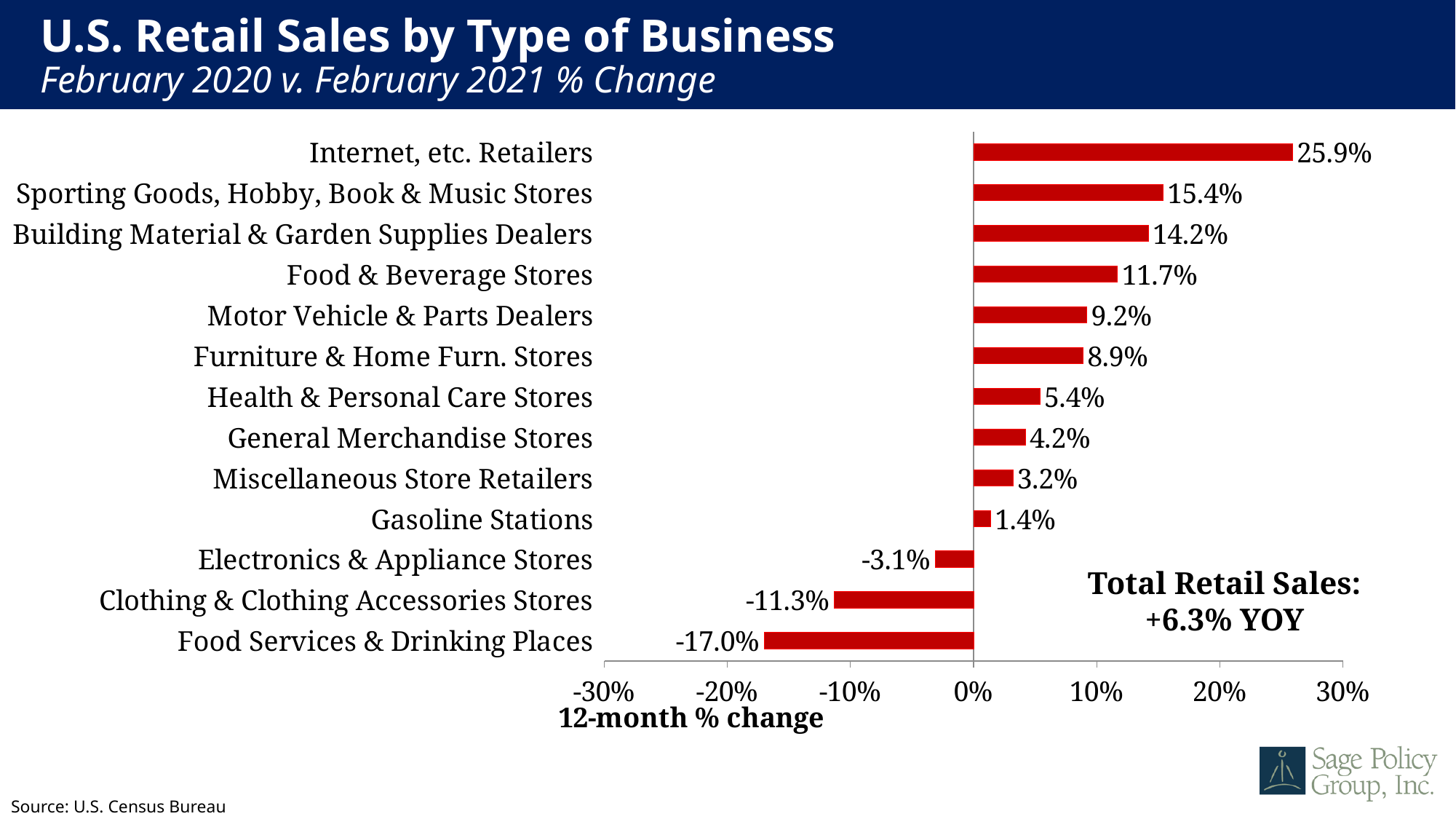
What is the 12-month % change for Food Services & Drinking Places? -17.0% How many types of business show a negative 12-month % change? 3 What kind of chart is shown on the slide? Bar chart Which has a larger 12-month % change, Food & Beverage Stores or Motor Vehicle & Parts Dealers? Food & Beverage Stores Which type of business has the highest 12-month % change? Internet, etc. Retailers What is the 12-month % change for Internet, etc. Retailers? 25.9% Is the value for Clothing & Clothing Accessories Stores greater or less than -10%? less What is the difference between the 12-month % change for Sporting Goods, Hobby, Book & Music Stores and Building Material & Garden Supplies Dealers? 1.2% What is the total retail sales year-over-year change noted on the chart? +6.3% YOY Which type of business has the lowest 12-month % change? Food Services & Drinking Places What is the 12-month % change for Gasoline Stations? 1.4% How many types of business are shown in the chart? 13